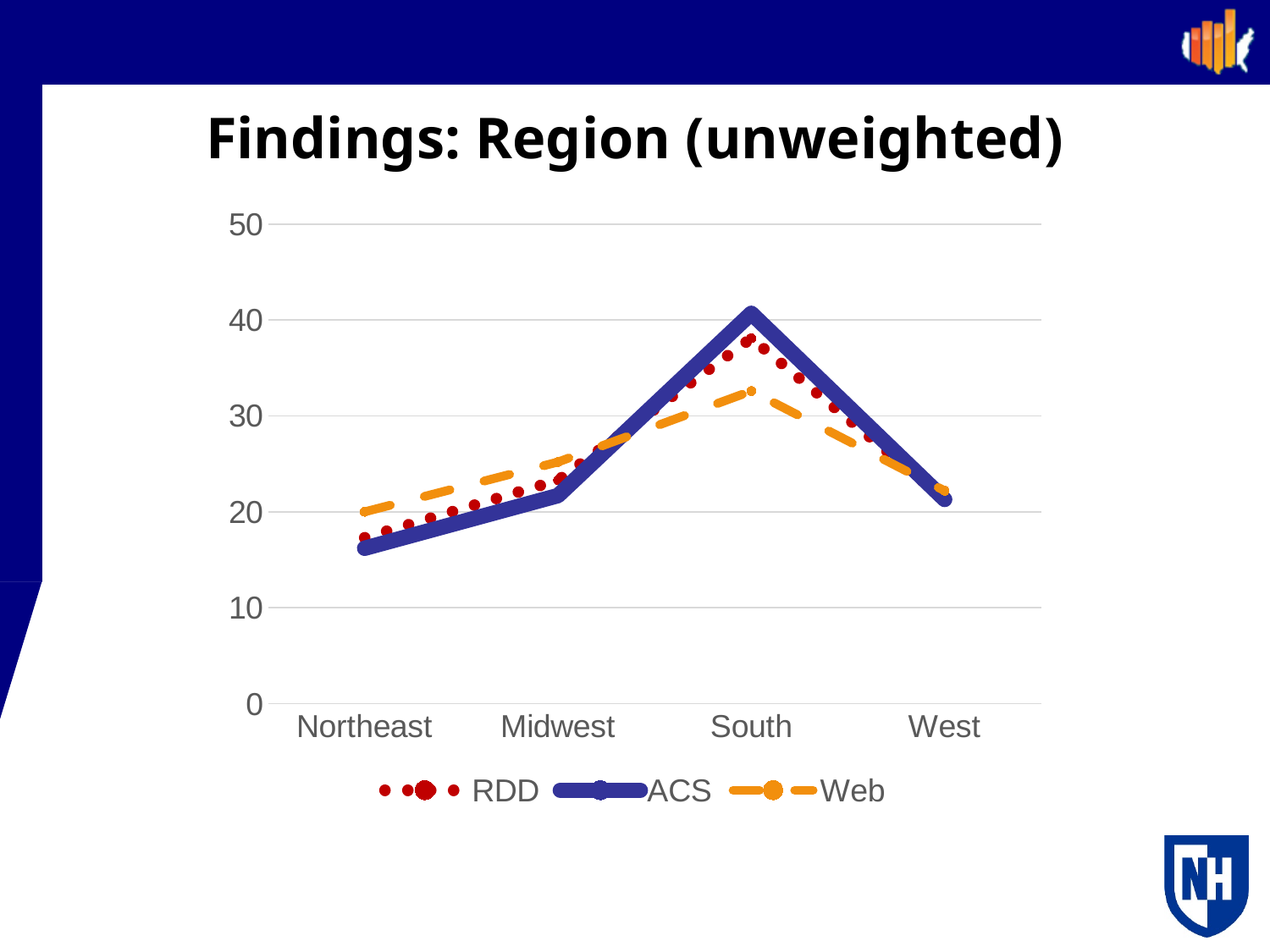
Which series are listed in the legend? RDD, ACS, Web In the South, which series has the larger value, ACS or Web? ACS How many regions are shown on the x axis? 4 How many series does the legend list? 3 What is the title of the chart on the slide? Findings: Region (unweighted) Is the ACS value for Northeast greater or less than 20? less For the Web series, which region has the highest value? South Is the ACS value for South greater or less than 30? greater For the ACS series, which region has the highest value? South Is the Web value for South greater or less than 40? less What kind of chart is shown on the slide? line chart For the ACS series, which region has the lowest value? Northeast